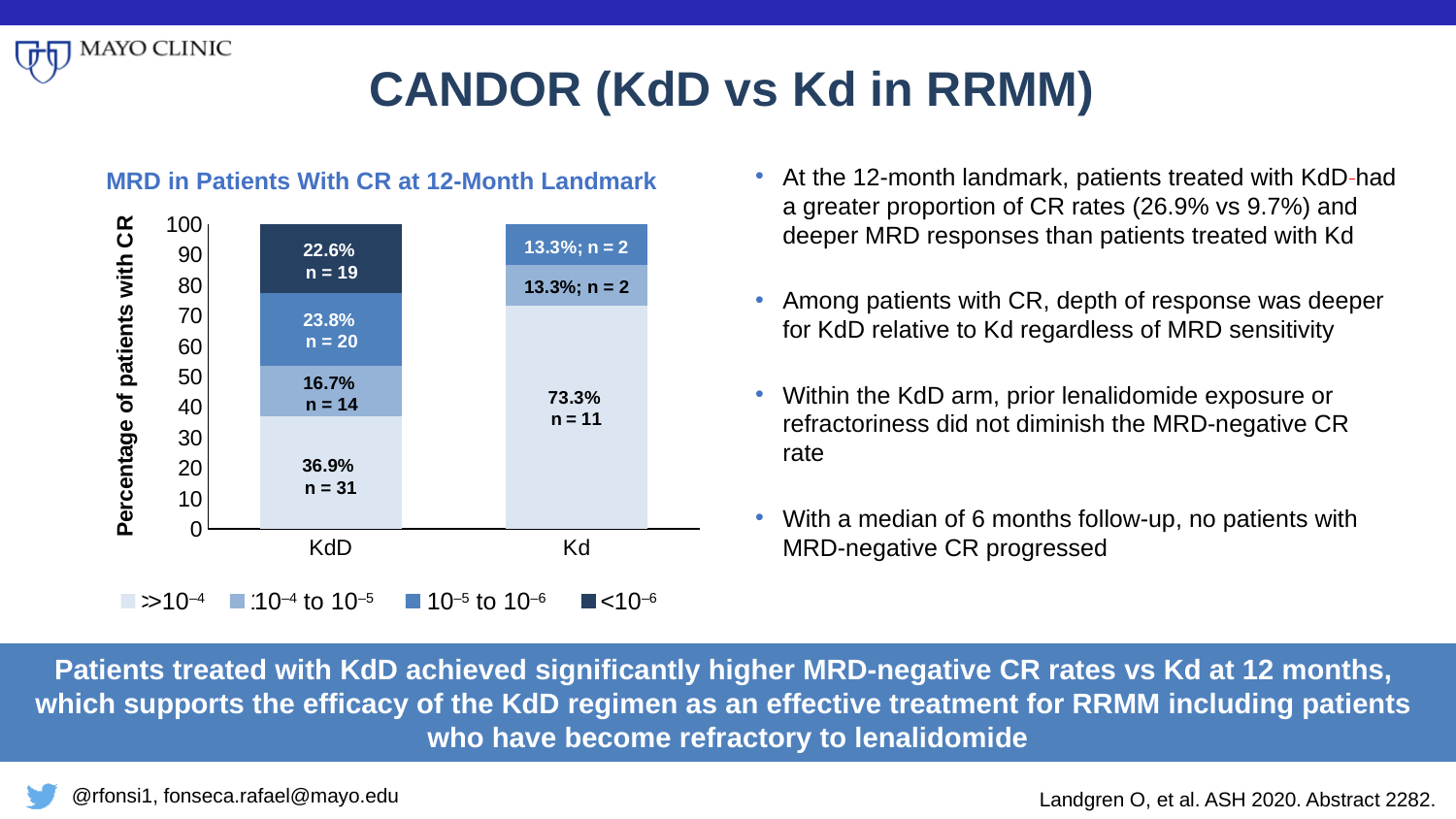
What percentage of Kd patients with CR had MRD >10⁻⁴? 73.3% How many KdD patients (n) are in the 10⁻⁵ to 10⁻⁶ MRD segment? n = 20 What kind of chart is shown on the slide? Stacked bar chart What percentage of KdD patients with CR had MRD >10⁻⁴? 36.9% What is the title of the chart? MRD in Patients With CR at 12-Month Landmark What percentage of KdD patients with CR had MRD <10⁻⁶? 22.6% What is the y-axis label of the chart? Percentage of patients with CR How many categories are shown on the x axis of the chart? 2 How many series does the chart legend list? 4 Which arm has the larger percentage of patients in the 10⁻⁵ to 10⁻⁶ MRD segment, KdD or Kd? KdD What is the difference in the >10⁻⁴ MRD percentage between Kd and KdD? 36.4% How many Kd patients (n) are in the 10⁻⁴ to 10⁻⁵ MRD segment? n = 2